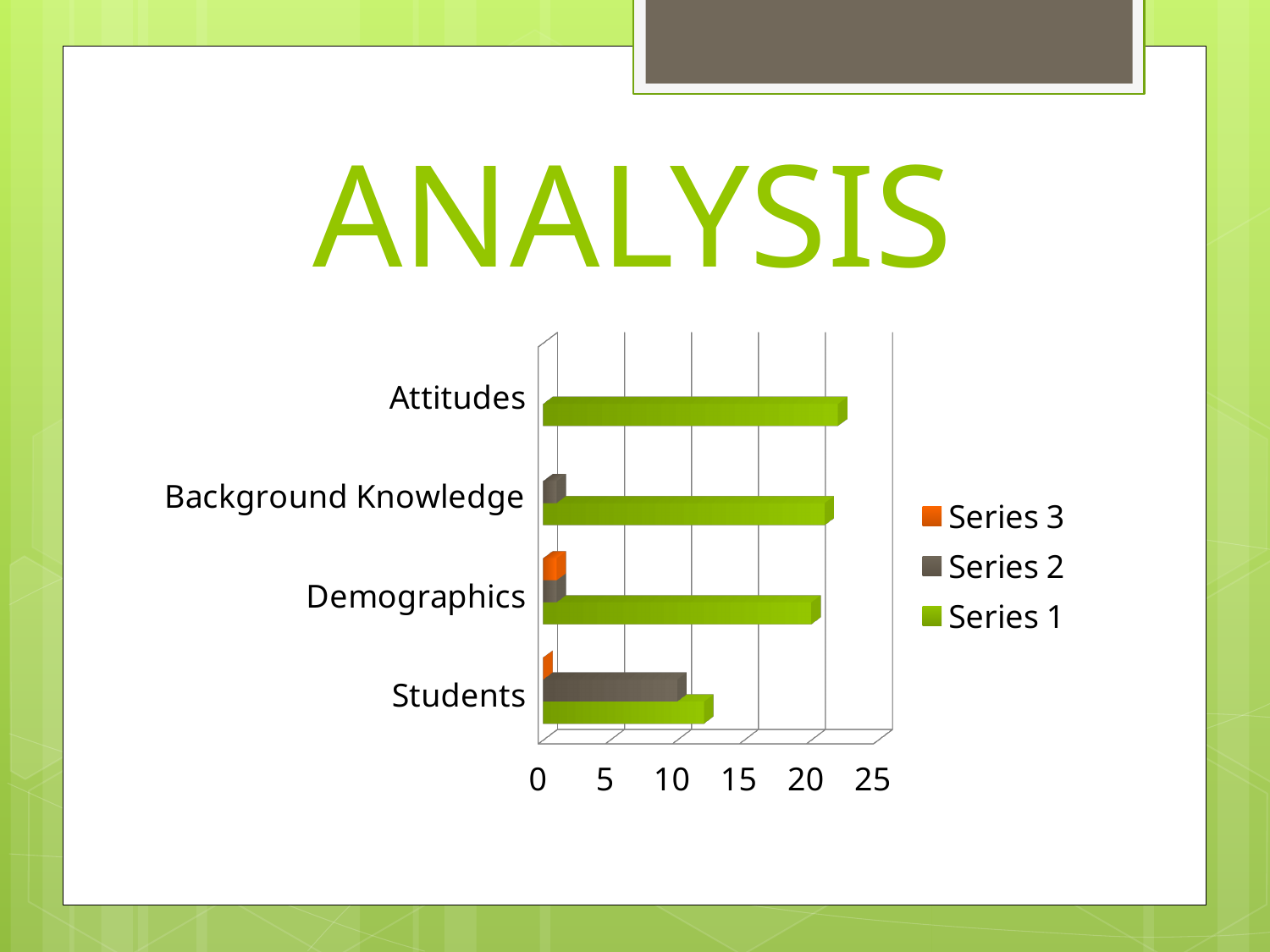
Is the Series 1 value for Students greater or less than 15? less How many categories are shown on the chart? 4 Which category has the lowest Series 1 value? Students Which is larger, the Series 1 value for Attitudes or the Series 1 value for Students? Attitudes What kind of chart is shown on the slide? bar chart How many series does the legend list? 3 What colour are the Series 1 bars? green Is the Series 1 value for Attitudes greater or less than 20? greater What is the title shown above the chart? ANALYSIS Which category has the highest Series 2 value? Students Is the Series 2 value for Students greater or less than 5? greater